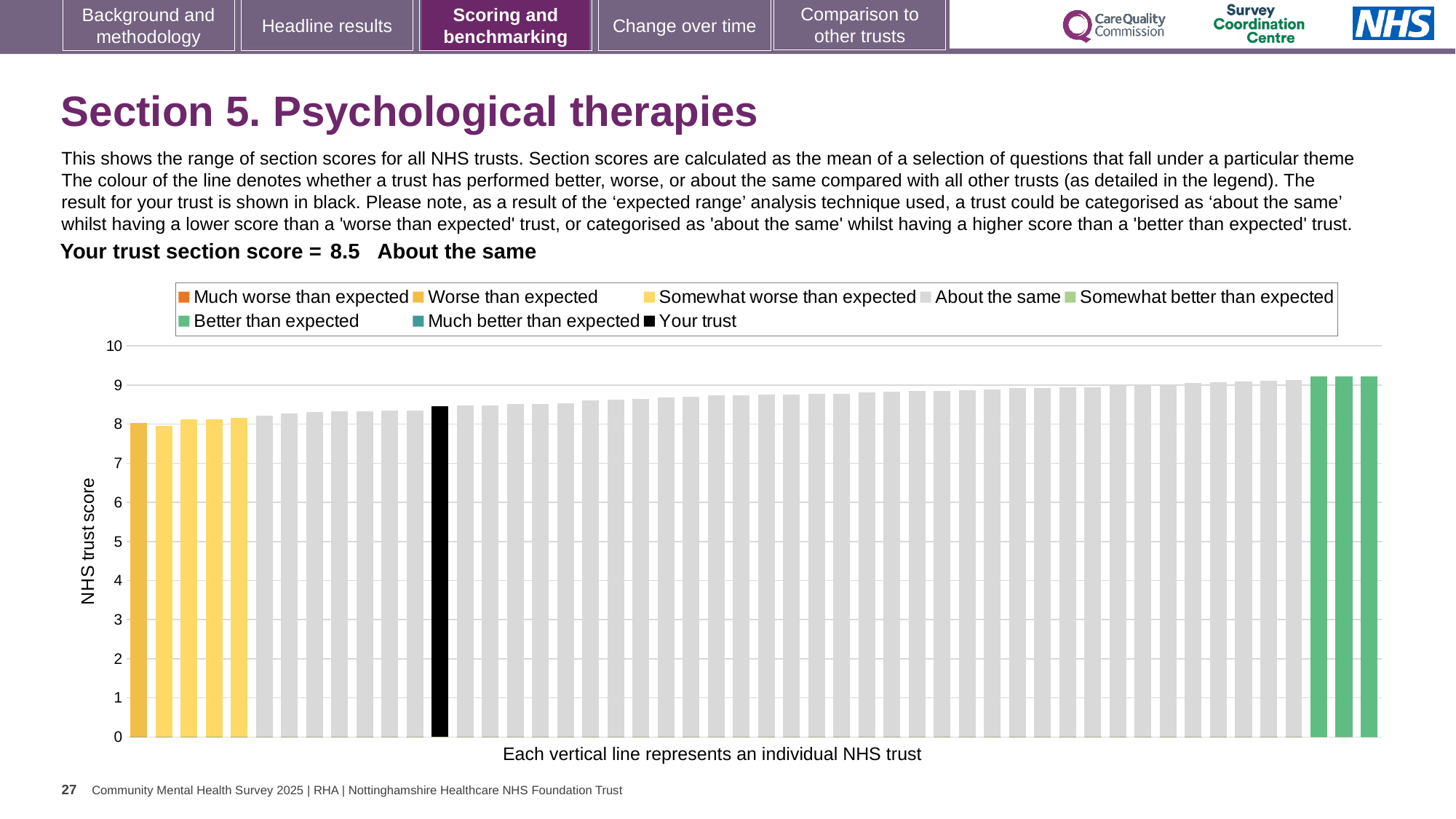
What is the highest value shown on the vertical axis? 10 How many entries does the chart legend list? 8 Which is larger: the black 'Your trust' bar or the rightmost green bar? the rightmost green bar Do the bar values rise or fall from left to right along the x axis? rise What category is your trust's section score placed in, according to the text above the chart? About the same Is the value of the black 'Your trust' bar greater or less than 8? greater What is the section score for your trust shown on the slide? 8.5 Is the value of the rightmost green bar greater or less than 9? greater How many green 'Better than expected' bars are shown in the chart? 3 What is the label on the vertical axis of the chart? NHS trust score What kind of chart is shown on the slide? bar chart Is the value of the leftmost bar greater or less than 9? less